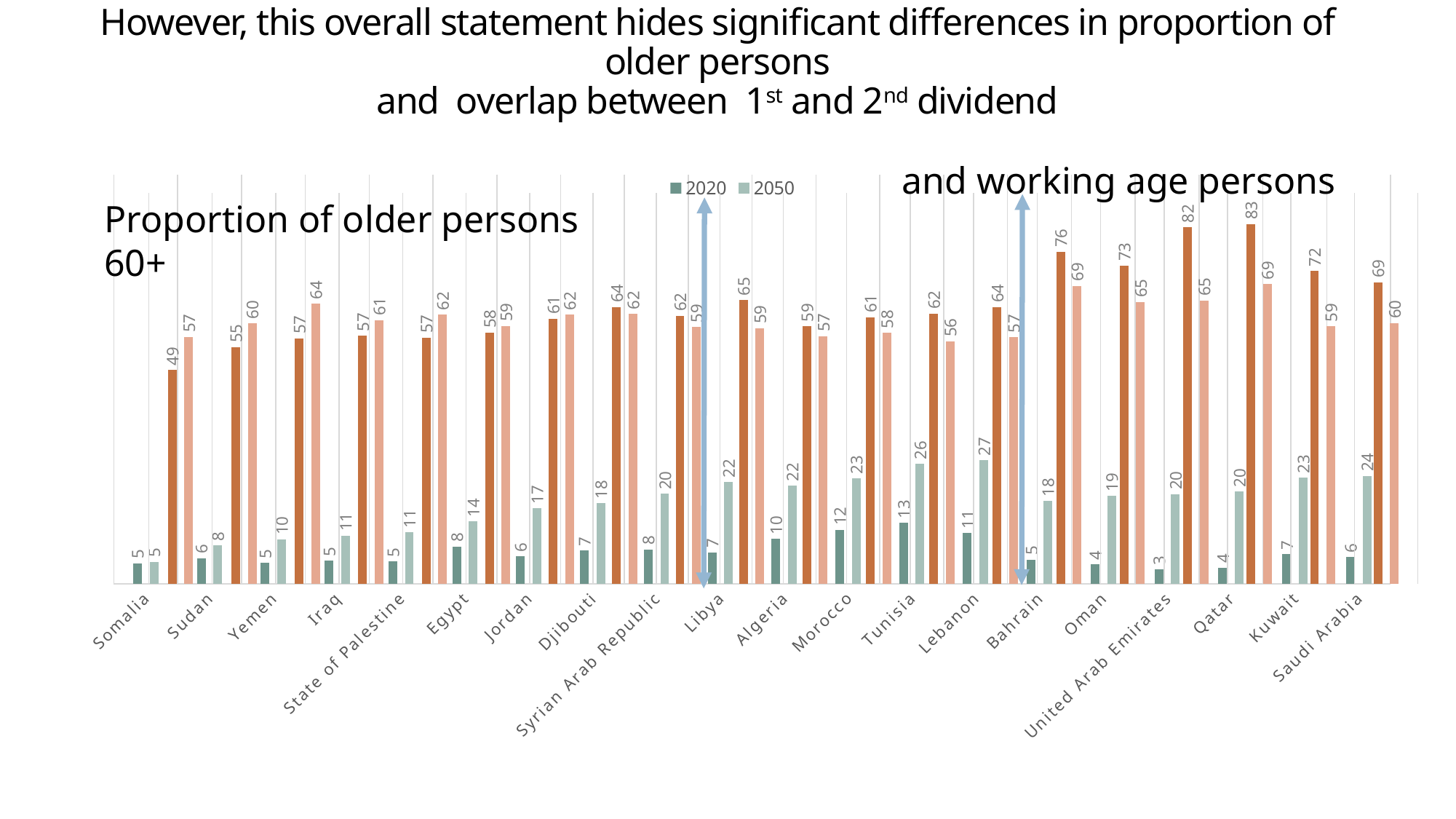
What is the 2050 value for the proportion of older persons 60+ in Lebanon? 27 What is the highest 2020 value for the proportion of working age persons, and which country has it? 83, Qatar Is the 2050 proportion of older persons 60+ larger in Morocco or in Egypt? Morocco What kind of chart is shown on the slide? bar chart What is the 2020 value for the proportion of working age persons in Bahrain? 76 Which country has the lowest 2020 proportion of older persons 60+? United Arab Emirates Which two years are listed in the chart legend? 2020 and 2050 How many series does the chart legend list? 2 What is the difference between the 2050 and 2020 proportion of older persons 60+ in Saudi Arabia? 18 Which country has the highest 2050 proportion of older persons 60+? Lebanon What is the 2020 value for the proportion of older persons 60+ in Tunisia? 13 How many countries are shown on the x axis of the chart? 20